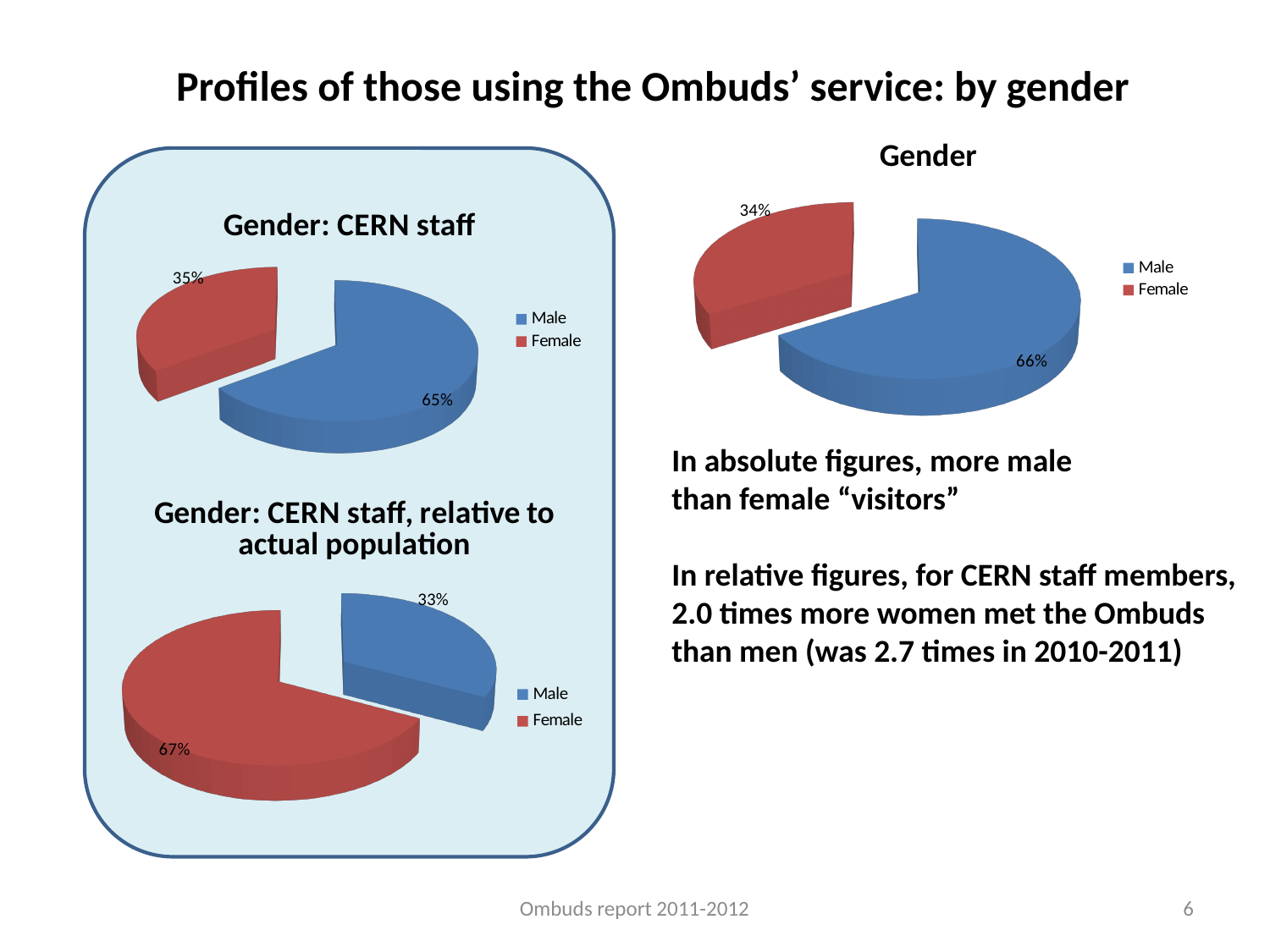
In the 'Gender: CERN staff, relative to actual population' pie chart, what share is Male? 33% How many entries does the legend of the 'Gender' chart list? 2 What kind of chart is the 'Gender: CERN staff' chart? Pie chart In the 'Gender' pie chart, what share is Female? 34% In the 'Gender: CERN staff, relative to actual population' pie chart, which category has the largest slice? Female In the 'Gender' pie chart, what share is Male? 66% In the 'Gender: CERN staff, relative to actual population' pie chart, what share is Female? 67% In the 'Gender: CERN staff' pie chart, what is the difference between the Male and Female shares? 30% In the 'Gender' pie chart, which is larger, Male or Female? Male In the 'Gender: CERN staff' pie chart, what share is Male? 65% In the 'Gender: CERN staff' pie chart, what share is Female? 35% In the 'Gender' pie chart, which category has the smallest slice? Female